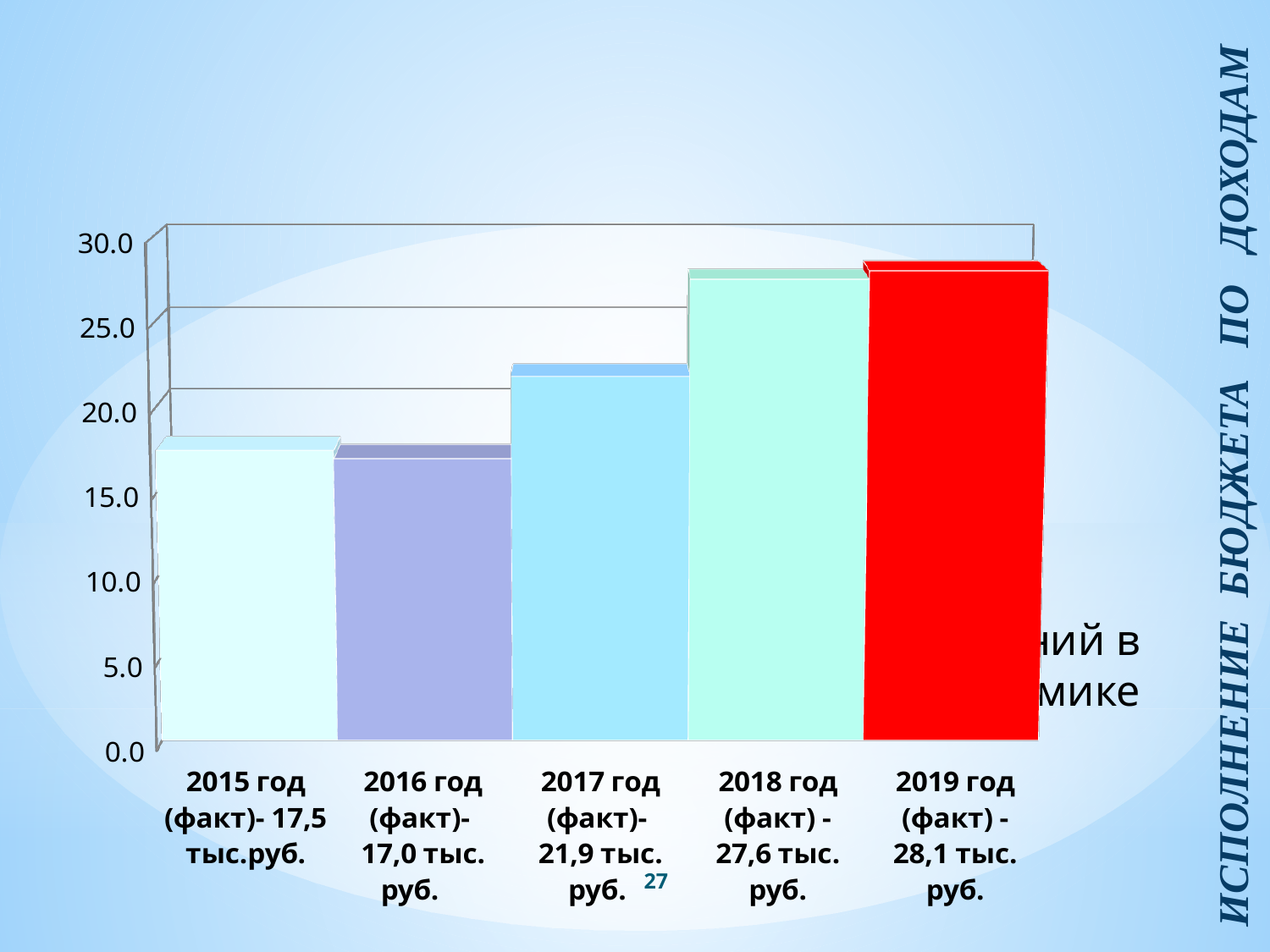
What value is shown for 2019 год (факт)? 28,1 тыс. руб. What is the difference between the values for 2019 год and 2015 год? 10,6 тыс. руб. What is the difference between the values for 2018 год and 2017 год? 5,7 тыс. руб. What kind of chart is shown on the slide? bar chart Is the value for 2018 год greater or less than 25.0? greater Which is larger, the value for 2016 год or the value for 2017 год? 2017 год What value is shown for 2015 год (факт)? 17,5 тыс.руб. Which year has the lowest value on the chart? 2016 год What value is shown for 2017 год (факт)? 21,9 тыс. руб. How many bars (years) are shown on the chart? 5 What colour is the bar for 2019 год? red Which year has the highest value on the chart? 2019 год